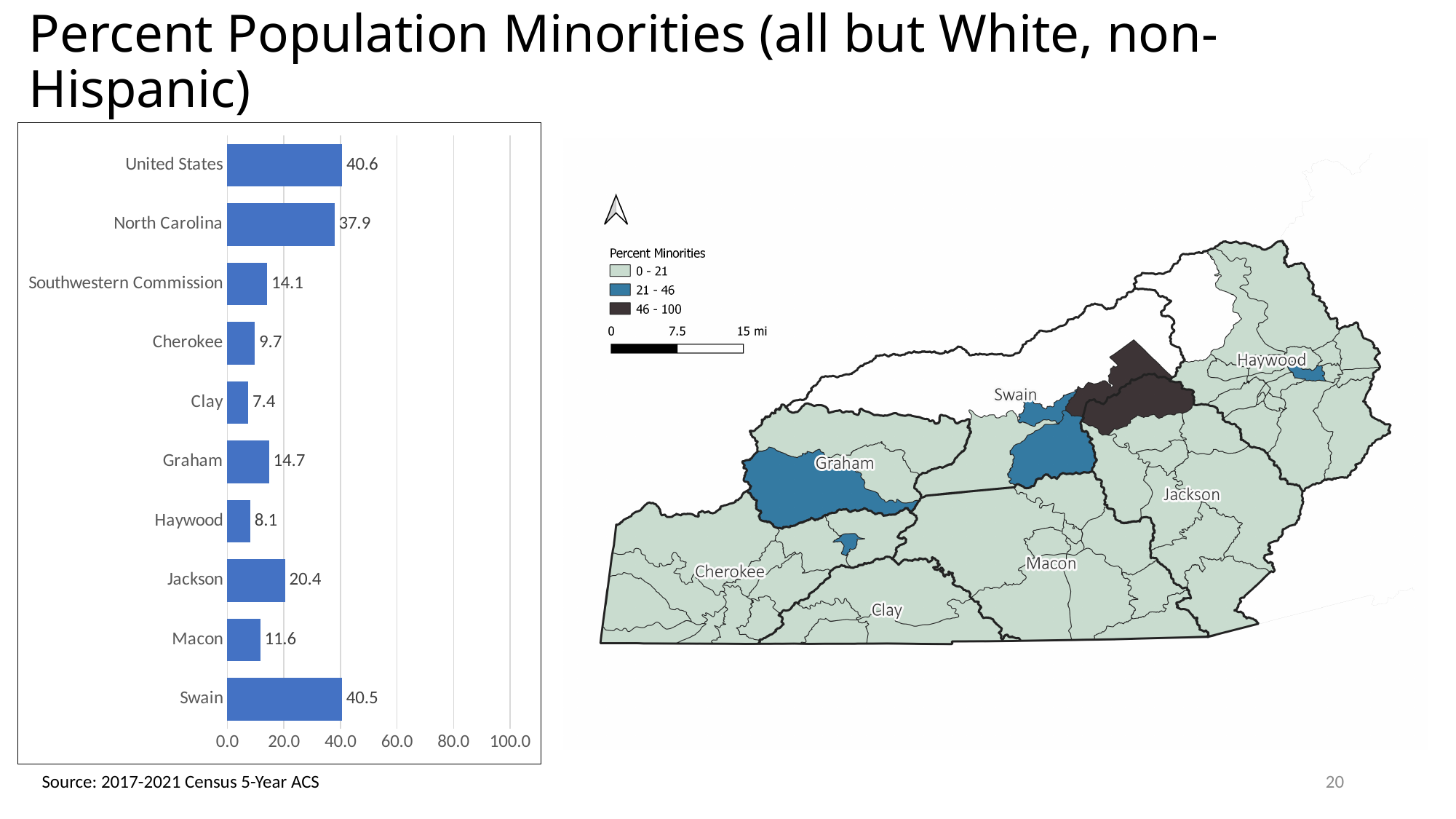
What is the value for Jackson in the bar chart? 20.4 What is the value for Southwestern Commission in the bar chart? 14.1 Which has a larger value in the bar chart, Graham or Cherokee? Graham Which category has the lowest value in the bar chart? Clay What is the difference between the values for United States and North Carolina in the bar chart? 2.7 What is the value for North Carolina in the bar chart? 37.9 What range does the darkest colour represent in the map legend? 46 - 100 What is the value for Swain in the bar chart? 40.5 How many categories are shown in the bar chart? 10 What kind of chart is shown on the left of the slide? bar chart What is the value for Macon in the bar chart? 11.6 Is the value for Jackson in the bar chart greater or less than 40.0? less